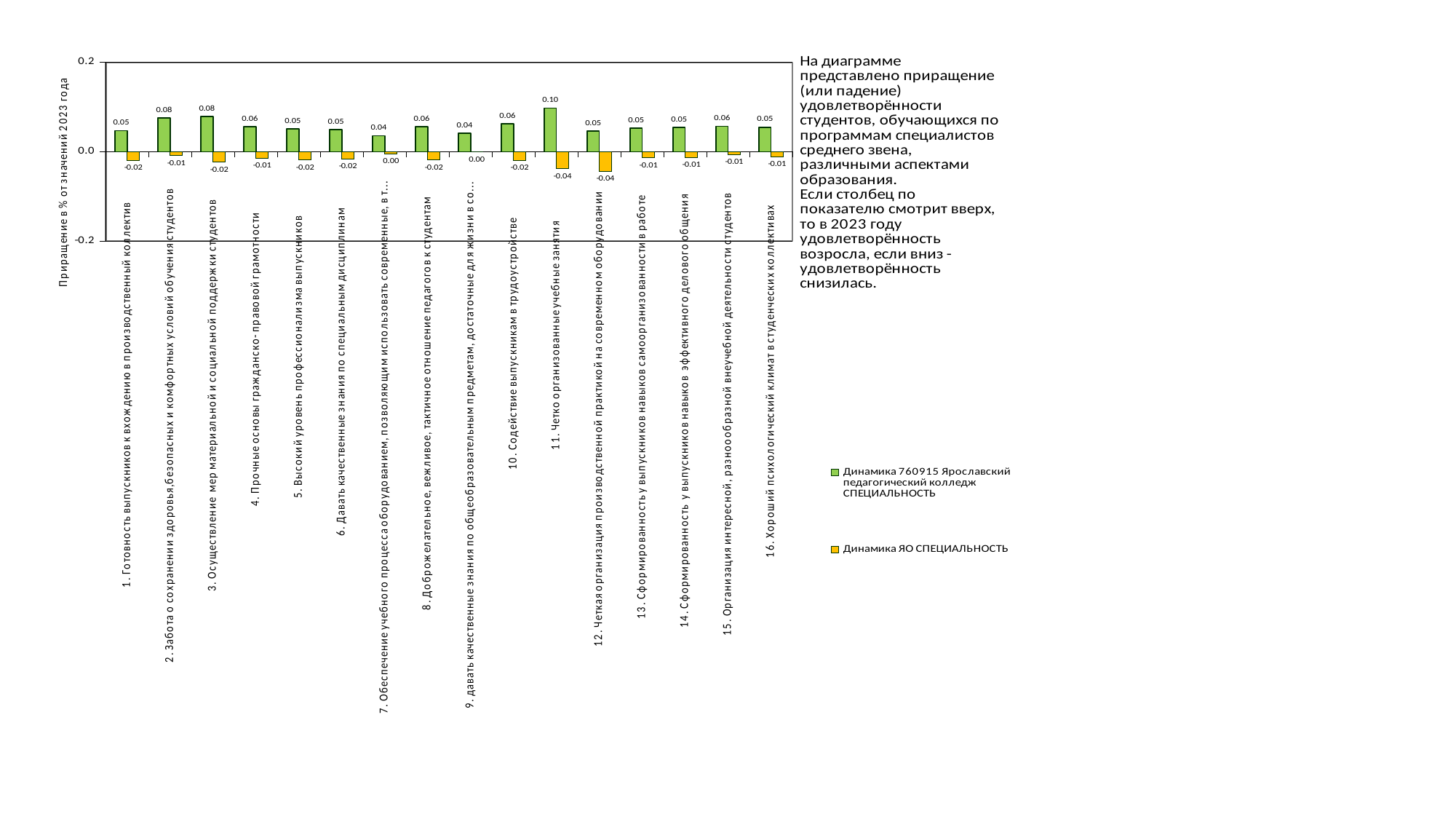
What is the value of the green series (Динамика 760915 Ярославский педагогический колледж СПЕЦИАЛЬНОСТЬ) for category 11, Четко организованные учебные занятия? 0.10 Which category has the highest value in the green series (Динамика 760915 Ярославский педагогический колледж СПЕЦИАЛЬНОСТЬ)? 11. Четко организованные учебные занятия In the green series, which is larger: the value for category 2 (Забота о сохранении здоровья) or category 4 (Прочные основы гражданско-правовой грамотности)? category 2 (Забота о сохранении здоровья) How many series does the legend list? 2 What is the value of the yellow series (Динамика ЯО СПЕЦИАЛЬНОСТЬ) for category 7, Обеспечение учебного процесса оборудованием? 0.00 What kind of chart is shown on the slide? bar chart Is the green series value for category 11, Четко организованные учебные занятия, greater or less than 0.2? less What is the value of the green series for category 3, Осуществление мер материальной и социальной поддержки студентов? 0.08 What is the difference between the green and yellow values for category 11, Четко организованные учебные занятия? 0.14 How many categories are plotted along the x axis? 16 Which colour represents the series Динамика ЯО СПЕЦИАЛЬНОСТЬ in the legend? yellow What is the value of the yellow series (Динамика ЯО СПЕЦИАЛЬНОСТЬ) for category 12, Четкая организация производственной практикой на современном оборудовании? -0.04